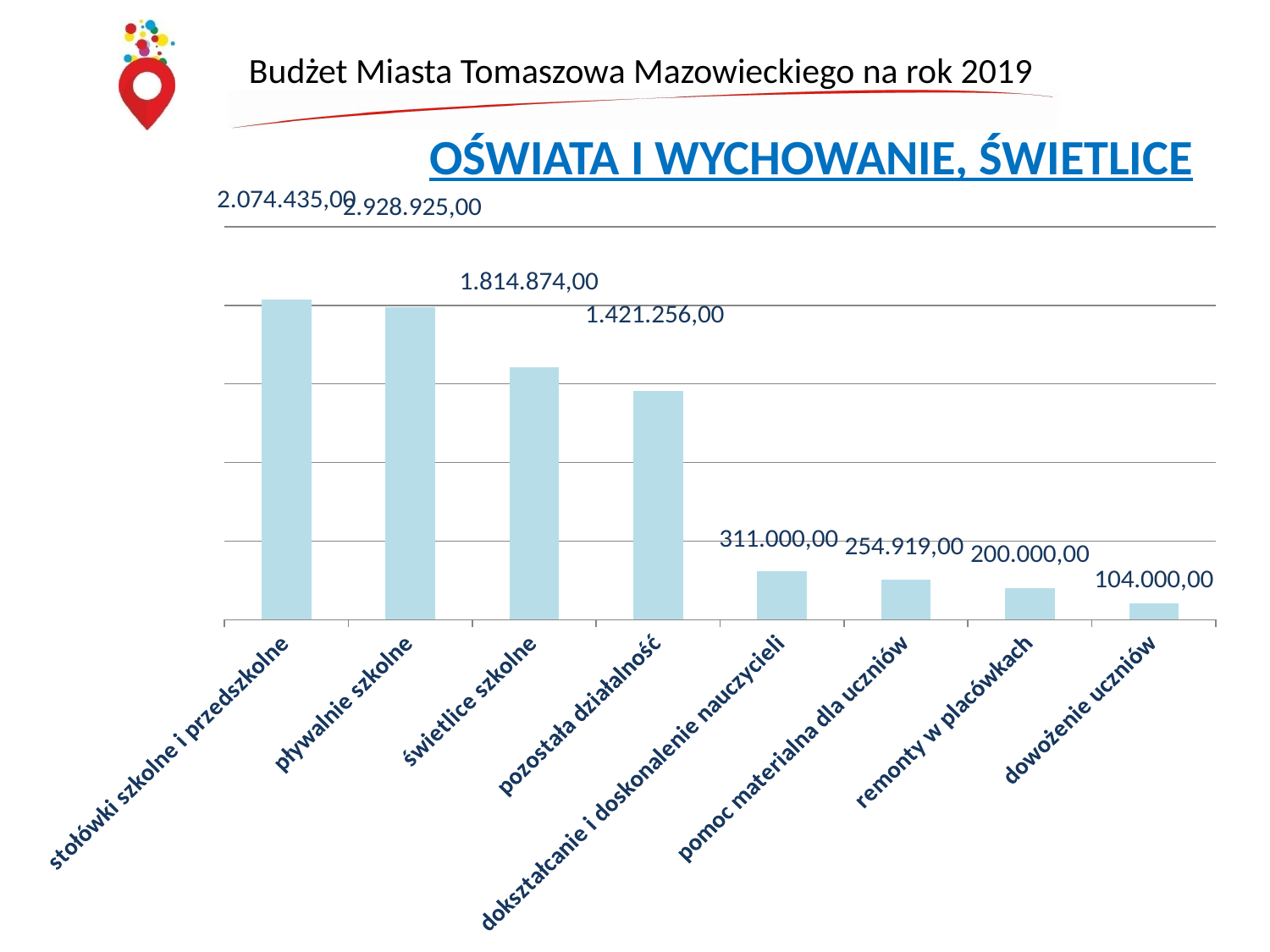
Which is larger, the value for pływalnie szkolne or the value for świetlice szkolne? pływalnie szkolne How many categories are shown in the chart? 8 Which category has the lowest value? dowożenie uczniów What is the value for remonty w placówkach? 200.000,00 What is the difference between the values for remonty w placówkach and dowożenie uczniów? 96.000,00 What is the value for pozostała działalność? 1.421.256,00 What is the value for pomoc materialna dla uczniów? 254.919,00 What is the value for dowożenie uczniów? 104.000,00 What is the difference between the values for świetlice szkolne and pozostała działalność? 393.618,00 What is the value for świetlice szkolne? 1.814.874,00 What is the value for dokształcanie i doskonalenie nauczycieli? 311.000,00